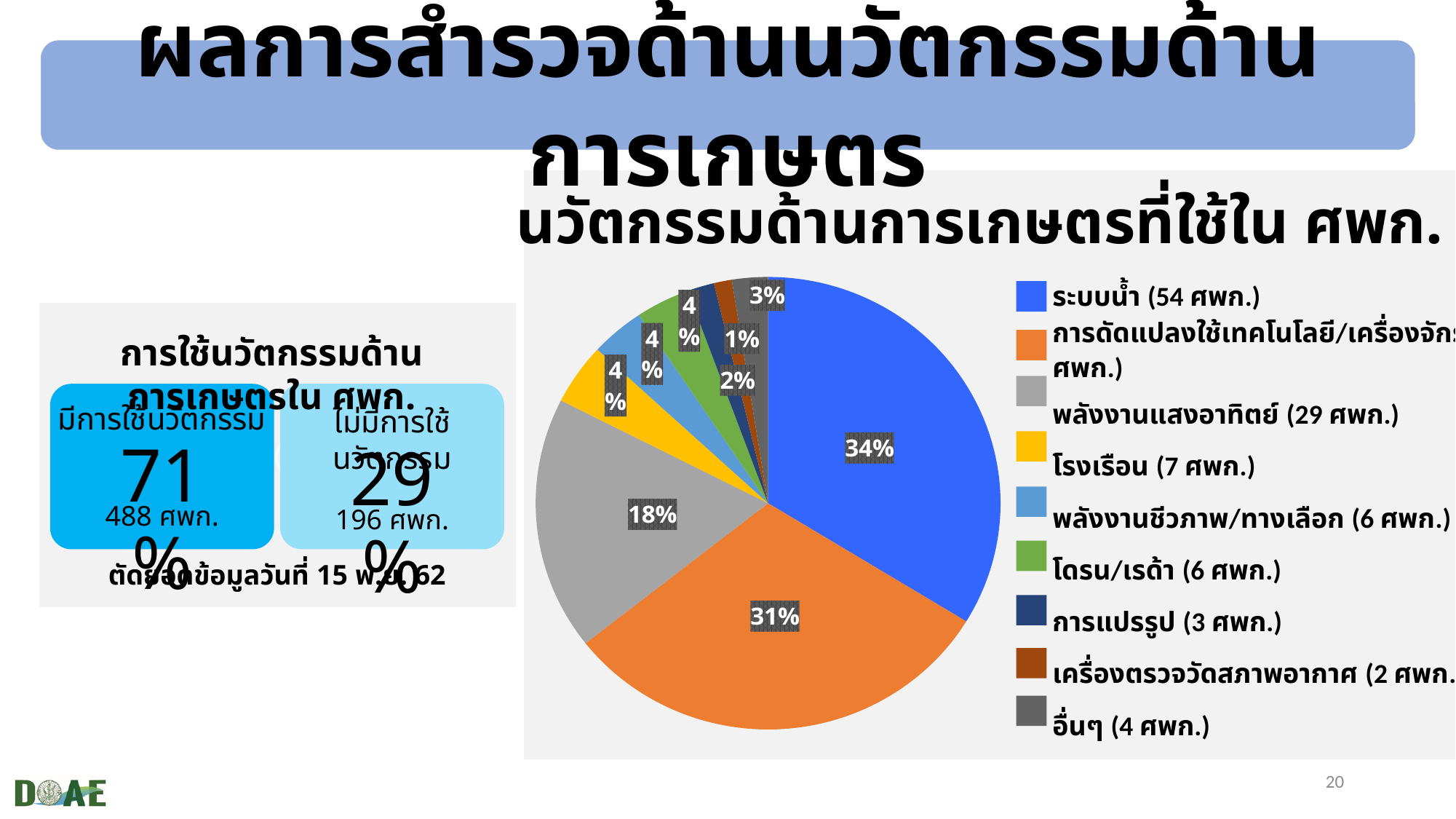
In the pie chart, what percentage is shown for ระบบน้ำ? 34% What colour is the slice for พลังงานแสงอาทิตย์ in the pie chart? gray In the pie chart, how many percentage points larger is the ระบบน้ำ slice than the พลังงานแสงอาทิตย์ slice? 16 In the pie chart, which is larger: the slice for พลังงานแสงอาทิตย์ or the slice for โรงเรือน? พลังงานแสงอาทิตย์ According to the legend of the pie chart, how many ศพก. use ระบบน้ำ? 54 ศพก. How many categories does the legend of the pie chart list? 9 In the pie chart, what percentage is shown for พลังงานแสงอาทิตย์? 18% In the pie chart, what percentage is shown for อื่นๆ? 3% What kind of chart is shown under the title นวัตกรรมด้านการเกษตรที่ใช้ใน ศพก.? pie chart Which category has the largest slice in the pie chart? ระบบน้ำ In the pie chart, what percentage is shown for การแปรรูป? 2% Which category has the smallest slice in the pie chart? เครื่องตรวจวัดสภาพอากาศ